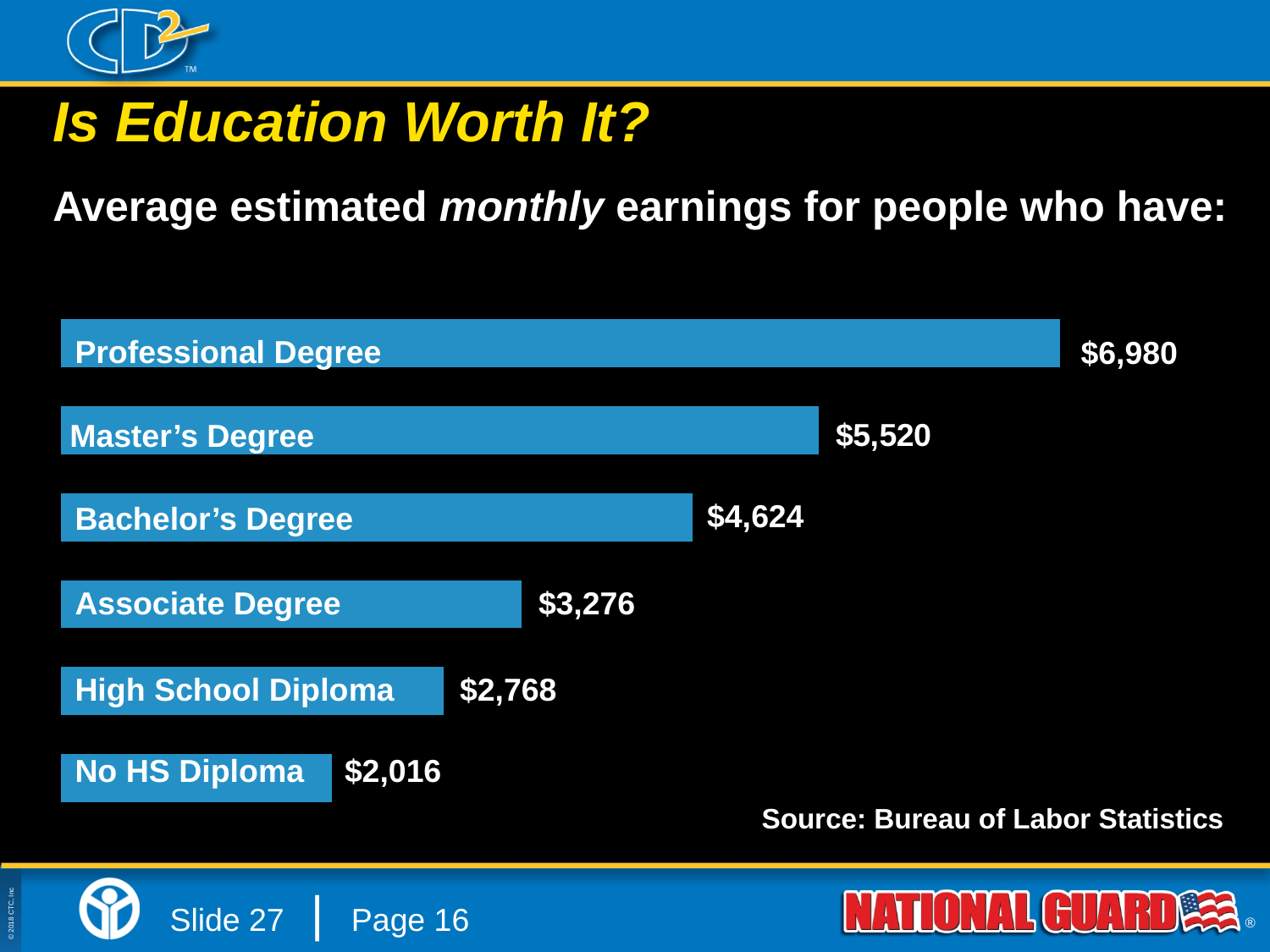
Which has higher monthly earnings, an Associate Degree or a High School Diploma? Associate Degree What is the average estimated monthly earnings for people with an Associate Degree? $3,276 What is the difference in monthly earnings between a Master's Degree and a Bachelor's Degree? $896 What kind of chart is shown on the slide? Bar chart What is the difference in monthly earnings between a High School Diploma and No HS Diploma? $752 What is the average estimated monthly earnings for people with No HS Diploma? $2,016 Which education level has the lowest average estimated monthly earnings? No HS Diploma How many education levels are shown in the chart? 6 What source is cited for the chart data? Bureau of Labor Statistics Which education level has the highest average estimated monthly earnings? Professional Degree What is the average estimated monthly earnings for people with a Bachelor's Degree? $4,624 What is the average estimated monthly earnings for people with a Professional Degree? $6,980